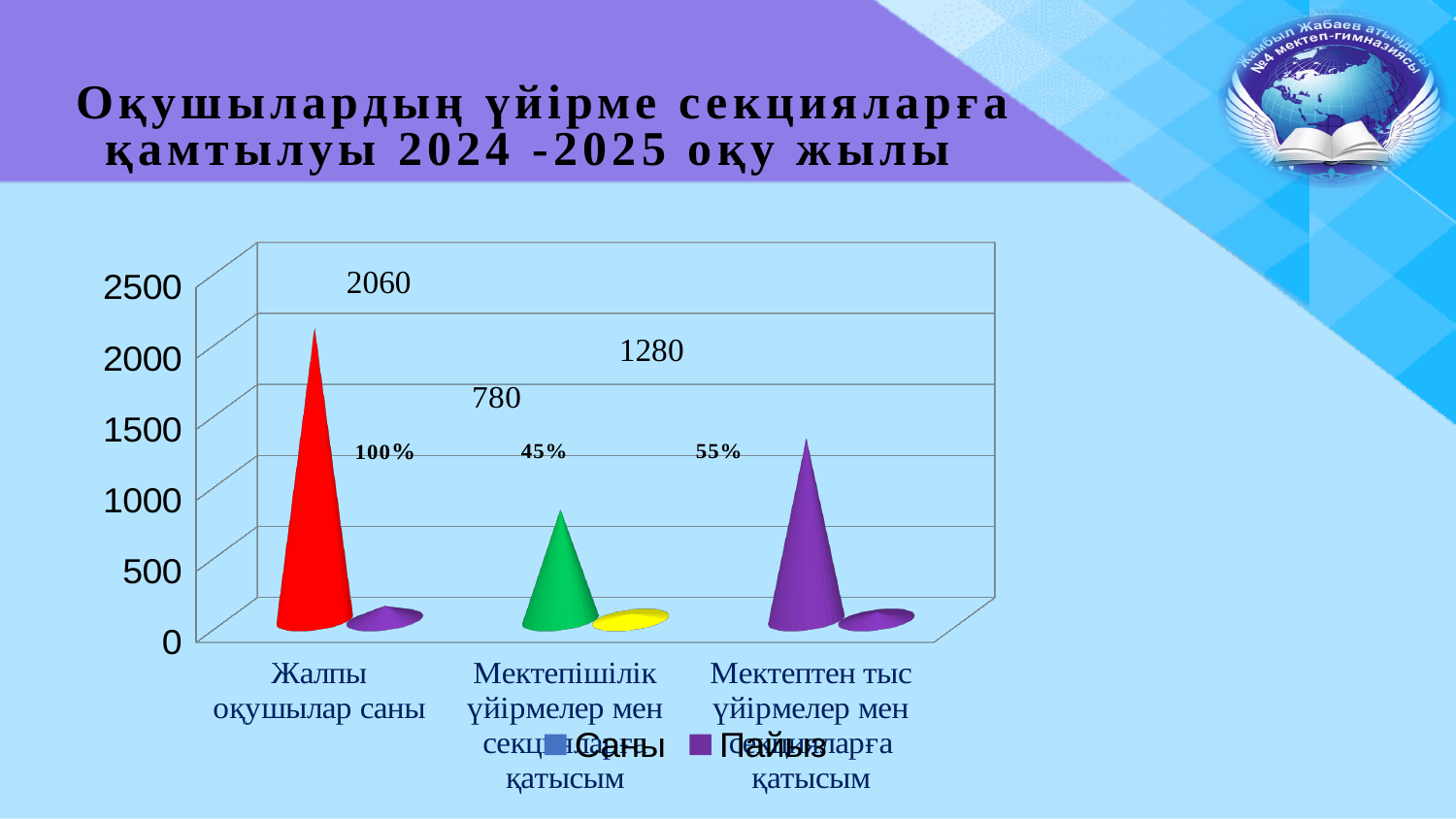
What percentage (Пайыз) is shown for Мектепішілік үйірмелер мен секцияларға қатысым? 45% What is the value of Саны for Жалпы оқушылар саны? 2060 Which category has the lowest Саны value? Мектепішілік үйірмелер мен секцияларға қатысым How many series does the legend list? 2 What is the value of Саны for Мектептен тыс үйірмелер мен секцияларға қатысым? 1280 Which category has the highest Саны value? Жалпы оқушылар саны Which is larger: the Саны value for Мектепішілік үйірмелер мен секцияларға қатысым or for Мектептен тыс үйірмелер мен секцияларға қатысым? Мектептен тыс үйірмелер мен секцияларға қатысым What percentage (Пайыз) is shown for Мектептен тыс үйірмелер мен секцияларға қатысым? 55% How many categories are shown on the x axis? 3 What is the value of Саны for Мектепішілік үйірмелер мен секцияларға қатысым? 780 What is the title of the chart slide? Оқушылардың үйірме секцияларға қамтылуы 2024 -2025 оқу жылы What is the difference between the Саны values for Мектептен тыс үйірмелер мен секцияларға қатысым and Мектепішілік үйірмелер мен секцияларға қатысым? 500